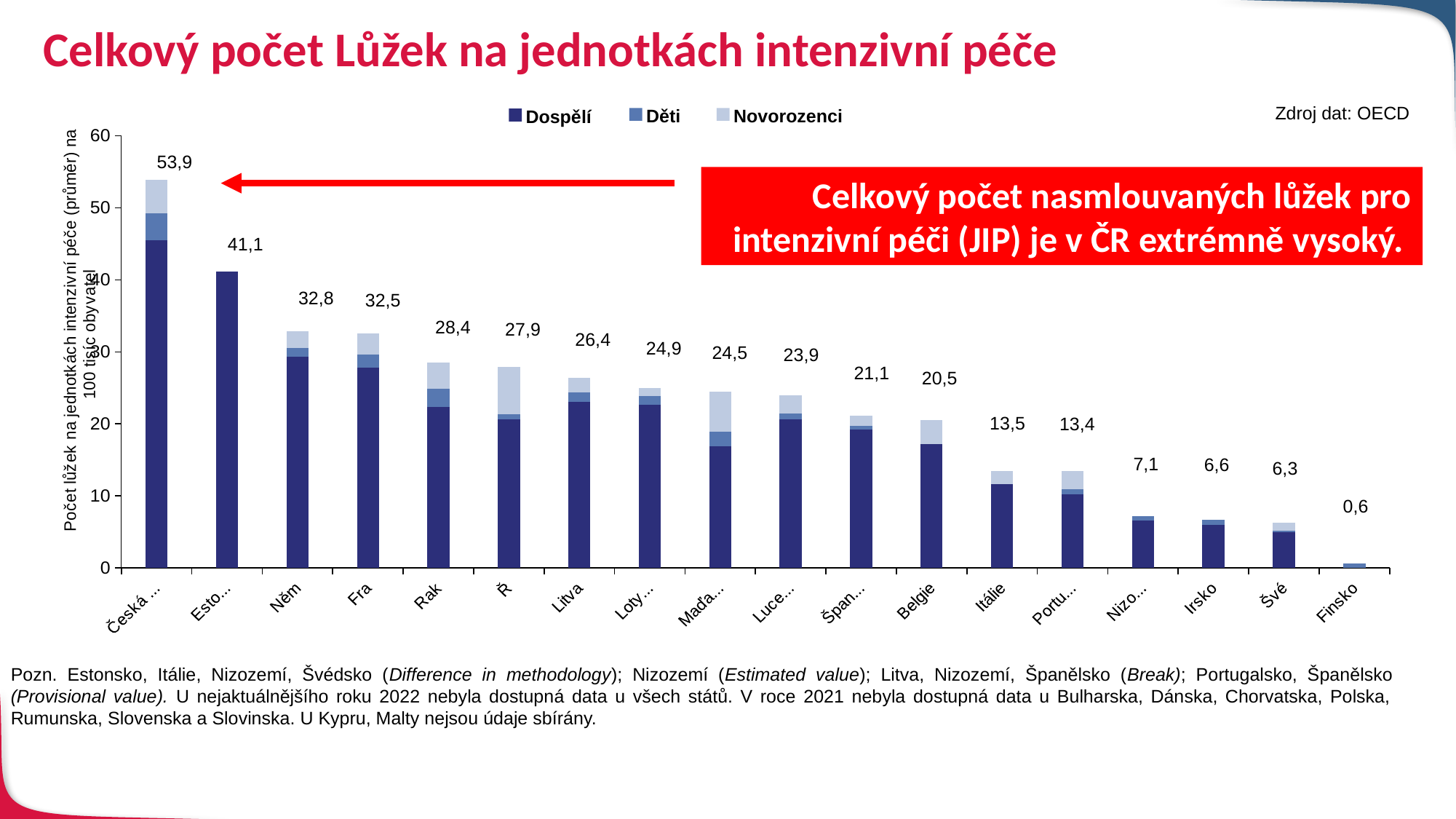
Which country has the lowest total number of intensive care beds? Finsko How many countries (bars) are plotted on the chart? 18 What is the total value labelled for Litva? 26,4 What is the difference between the totals for Belgie and Itálie? 7,0 How many series does the legend list? 3 Do the total values rise or fall from left to right along the x axis? fall What kind of chart is shown on the slide? bar chart Which has the larger total, Fra or Rak? Fra What is the total value labelled for Belgie? 20,5 What data source is cited on the slide? OECD What is the total value labelled for Itálie? 13,5 Is the Dospělí (adults) segment for Belgie greater or less than 20? less